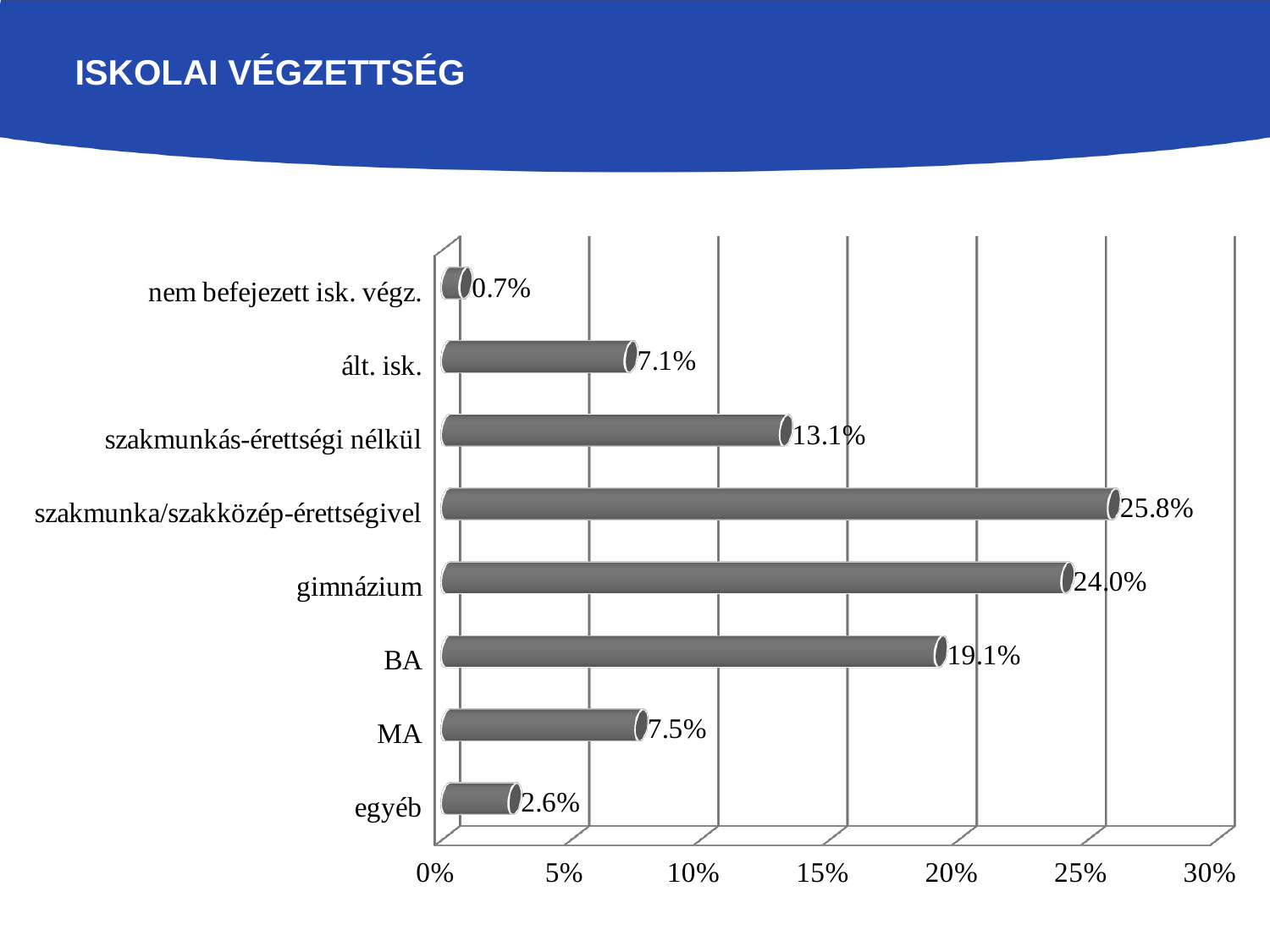
What is the difference between the values for szakmunka/szakközép-érettségivel and gimnázium? 1.8% Is the value for BA greater or less than 20%? less What is the value for BA? 19.1% What is the difference between the values for MA and ált. isk.? 0.4% What is the value for gimnázium? 24.0% Which is larger, the value for BA or the value for szakmunkás-érettségi nélkül? BA What is the value for egyéb? 2.6% Which category has the highest value? szakmunka/szakközép-érettségivel How many categories are shown in the chart? 8 What kind of chart is shown on the slide? bar chart What is the value for szakmunkás-érettségi nélkül? 13.1% Which category has the lowest value? nem befejezett isk. végz.